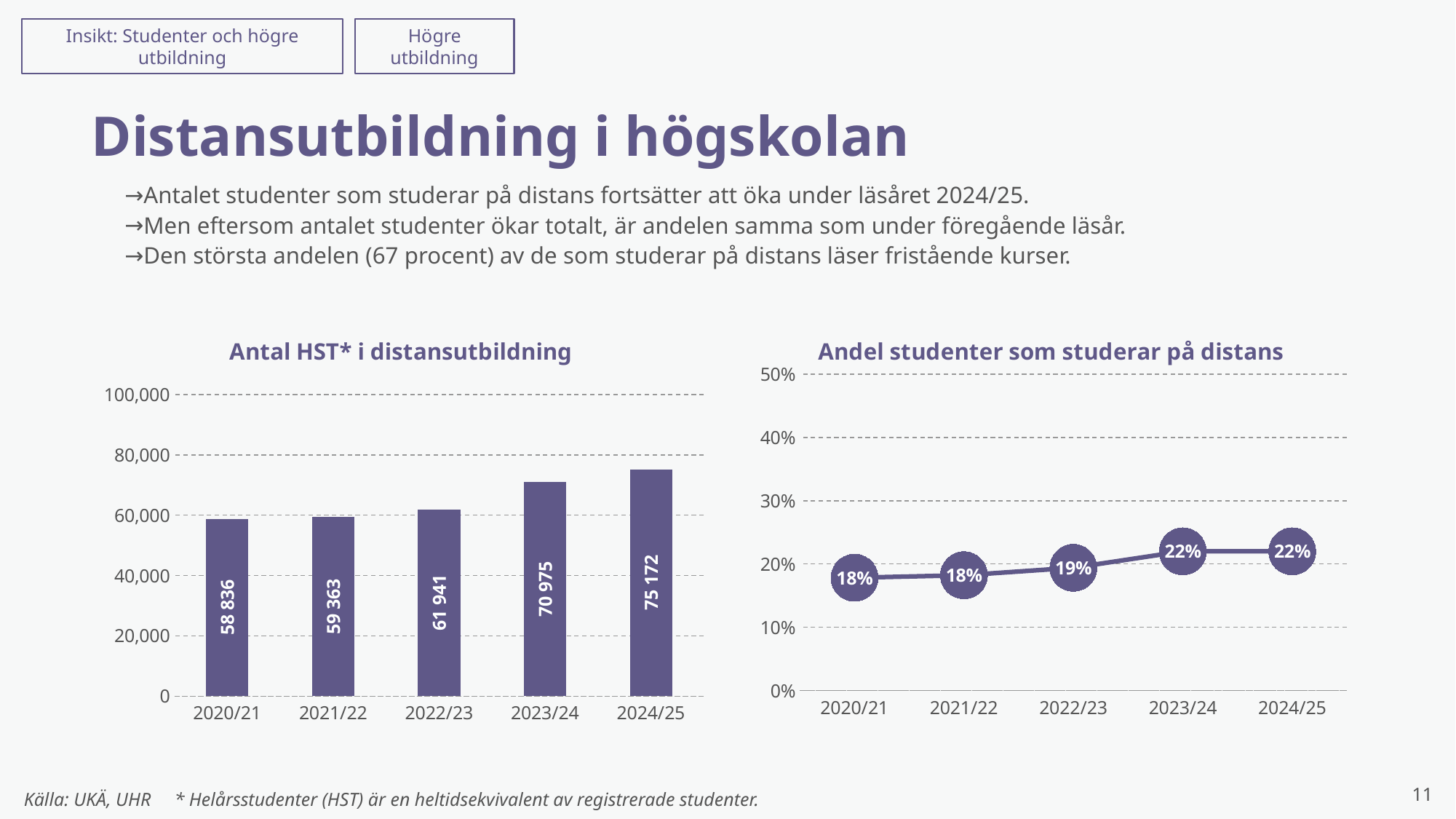
In the chart 'Andel studenter som studerar på distans', is the value for 2023/24 larger than the value for 2021/22? Yes What kind of chart is 'Andel studenter som studerar på distans'? Line chart In the chart 'Antal HST* i distansutbildning', which year has the lowest value? 2020/21 In the chart 'Andel studenter som studerar på distans', what is the value for 2020/21? 18% In the chart 'Antal HST* i distansutbildning', what is the value for 2022/23? 61 941 In the chart 'Antal HST* i distansutbildning', is the value for 2023/24 greater or less than 60,000? greater In the chart 'Andel studenter som studerar på distans', what is the value for 2022/23? 19% What kind of chart is 'Antal HST* i distansutbildning'? Bar chart In the chart 'Andel studenter som studerar på distans', do the values generally rise or fall from 2020/21 to 2024/25? Rise In the chart 'Antal HST* i distansutbildning', what is the difference between the values for 2024/25 and 2023/24? 4 197 In the chart 'Antal HST* i distansutbildning', which year has the highest value? 2024/25 In the chart 'Antal HST* i distansutbildning', how many years are shown? 5